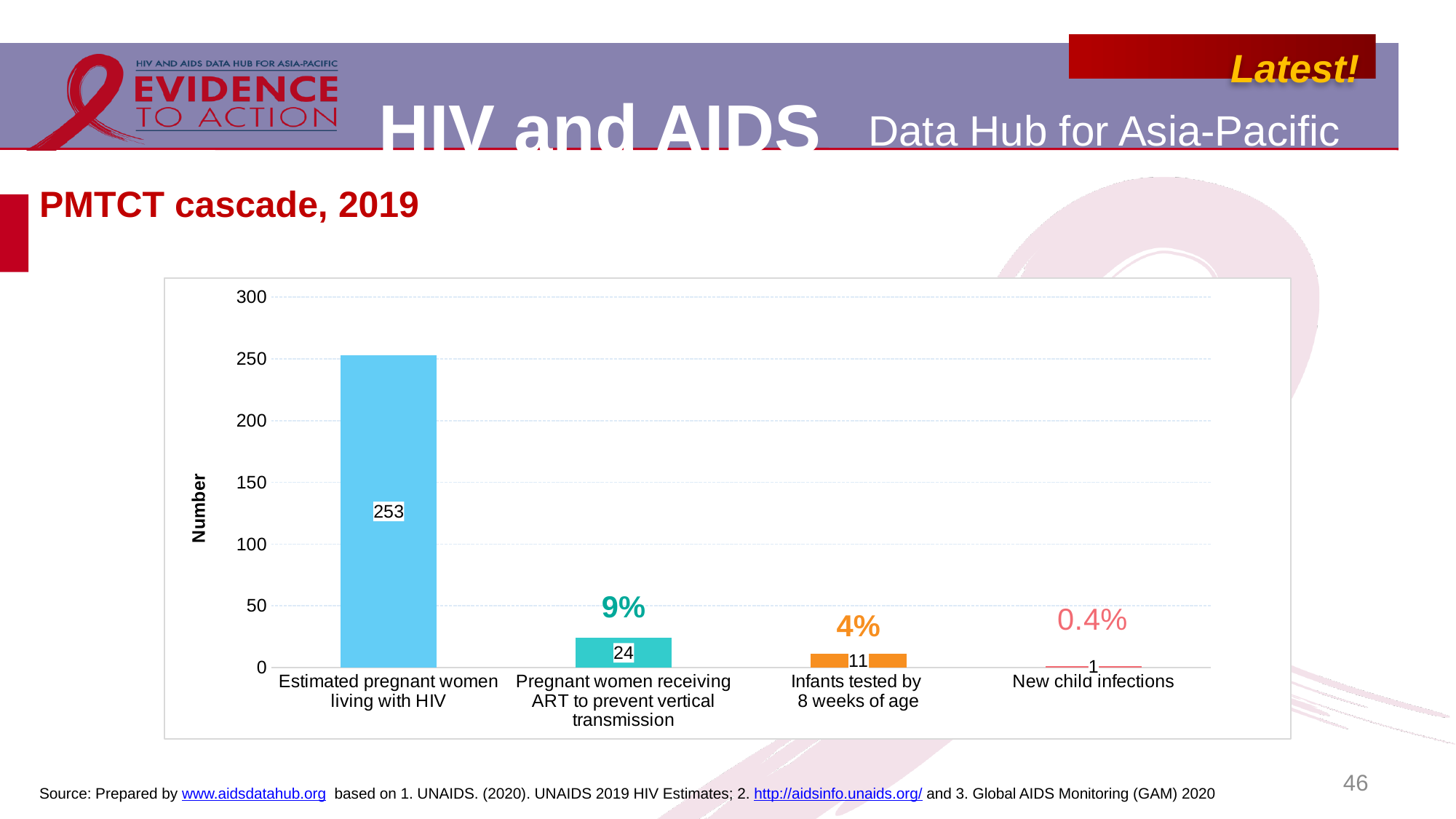
Which category has the highest value? Estimated pregnant women living with HIV What is the value for Estimated pregnant women living with HIV? 253 Do the values rise or fall from left to right along the x axis? Fall What is the value for Infants tested by 8 weeks of age? 11 What is the value for Pregnant women receiving ART to prevent vertical transmission? 24 Which category has the lowest value? New child infections What is the difference between Estimated pregnant women living with HIV and Pregnant women receiving ART to prevent vertical transmission? 229 What percentage label is shown above the Infants tested by 8 weeks of age bar? 4% What kind of chart is shown on the slide? Bar chart What is the value for New child infections? 1 Which is larger: Pregnant women receiving ART to prevent vertical transmission or Infants tested by 8 weeks of age? Pregnant women receiving ART to prevent vertical transmission How many categories are shown on the x axis? 4